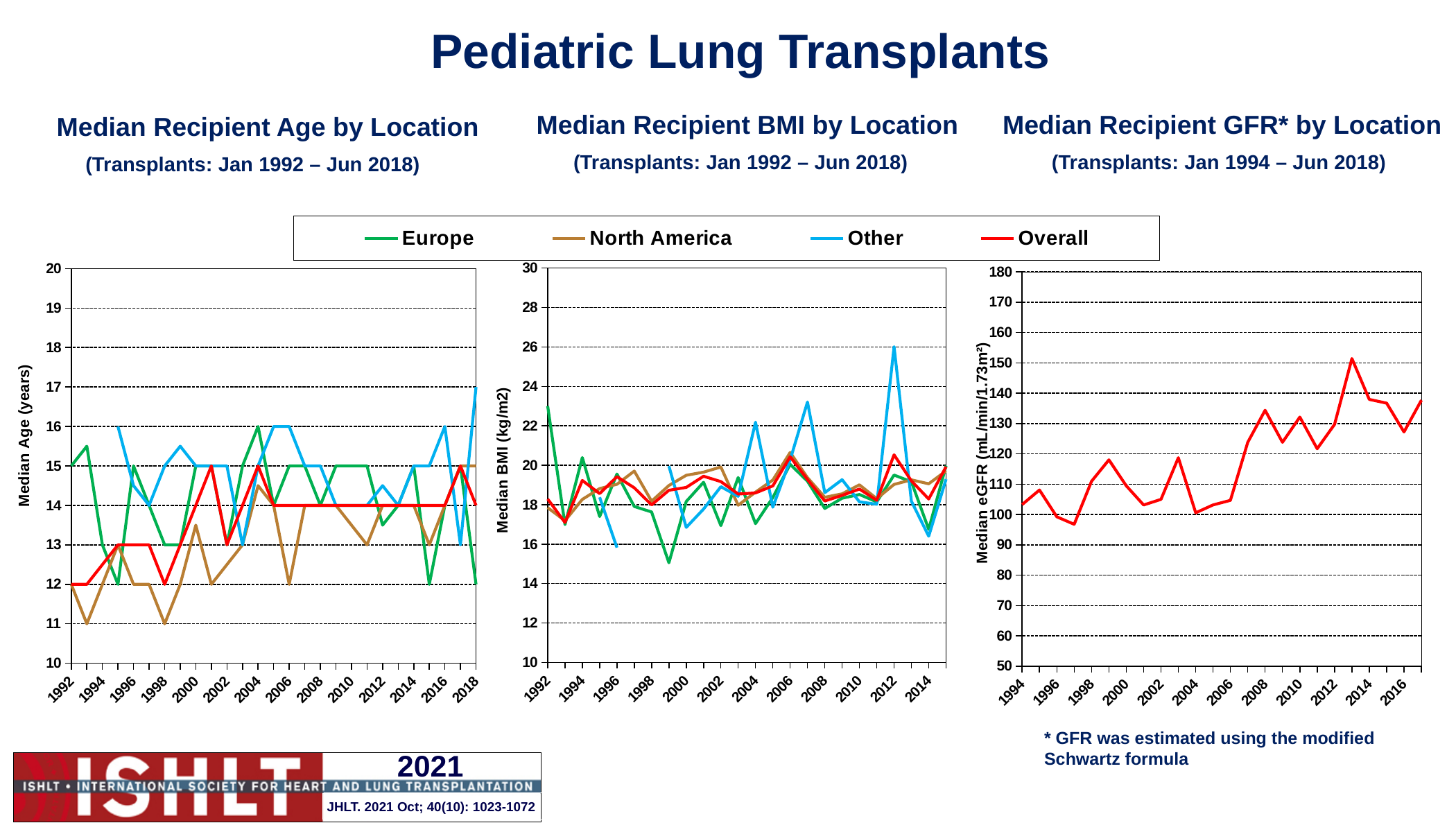
What is the y-axis label of the Median Recipient GFR* by Location chart? Median eGFR (mL/min/1.73m²) In the Median Recipient GFR* by Location chart, is the value in 2013 greater or less than 140? greater What kind of chart is the Median Recipient Age by Location chart? line chart In the Median Recipient Age by Location chart, which series has the highest median age in 2018? Other How many series does the shared legend list? 4 In the Median Recipient GFR* by Location chart, do the values generally rise or fall from 1994 to 2017? rise In the Median Recipient BMI by Location chart, is the value for Other in 2012 greater or less than 24? greater In the Median Recipient Age by Location chart, which series has the lowest median age in 2018? Europe In the Median Recipient Age by Location chart, what is the difference between the Other and Europe median ages in 2018? 5 In the Median Recipient Age by Location chart, what is the median age for Europe in 2018? 12 In the Median Recipient Age by Location chart, what is the median age for North America in 1993? 11 In the Median Recipient Age by Location chart, what is the median age for Other in 2018? 17